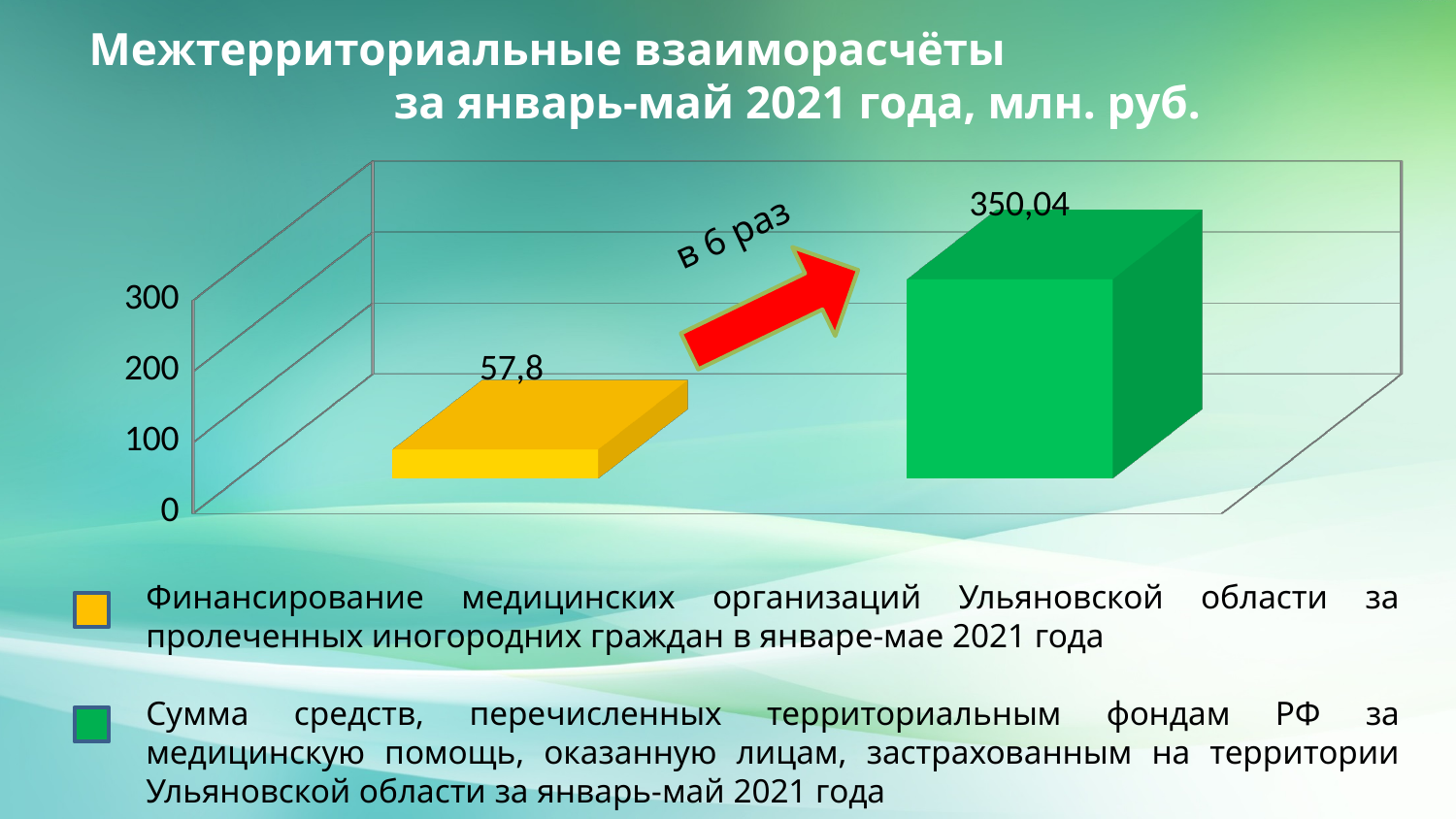
What is the difference between the green bar value (350,04) and the yellow bar value (57,8)? 292,24 Which bar has the lowest value on the chart? the yellow one (57,8) Which bar has the higher value, the yellow one or the green one? the green one (350,04) How many bars are plotted on the chart? 2 What value is shown on the green bar (funds transferred to territorial funds of the RF)? 350,04 Is the value of the yellow bar greater or less than 100? less What type of chart is shown on the slide? bar chart What is the highest tick value shown on the vertical axis? 300 What value is shown on the yellow bar (financing of Ulyanovsk region medical organisations for treated non-resident citizens)? 57,8 What text is written on the red arrow between the two bars? в 6 раз What is the unit of measurement stated in the chart title? млн. руб.